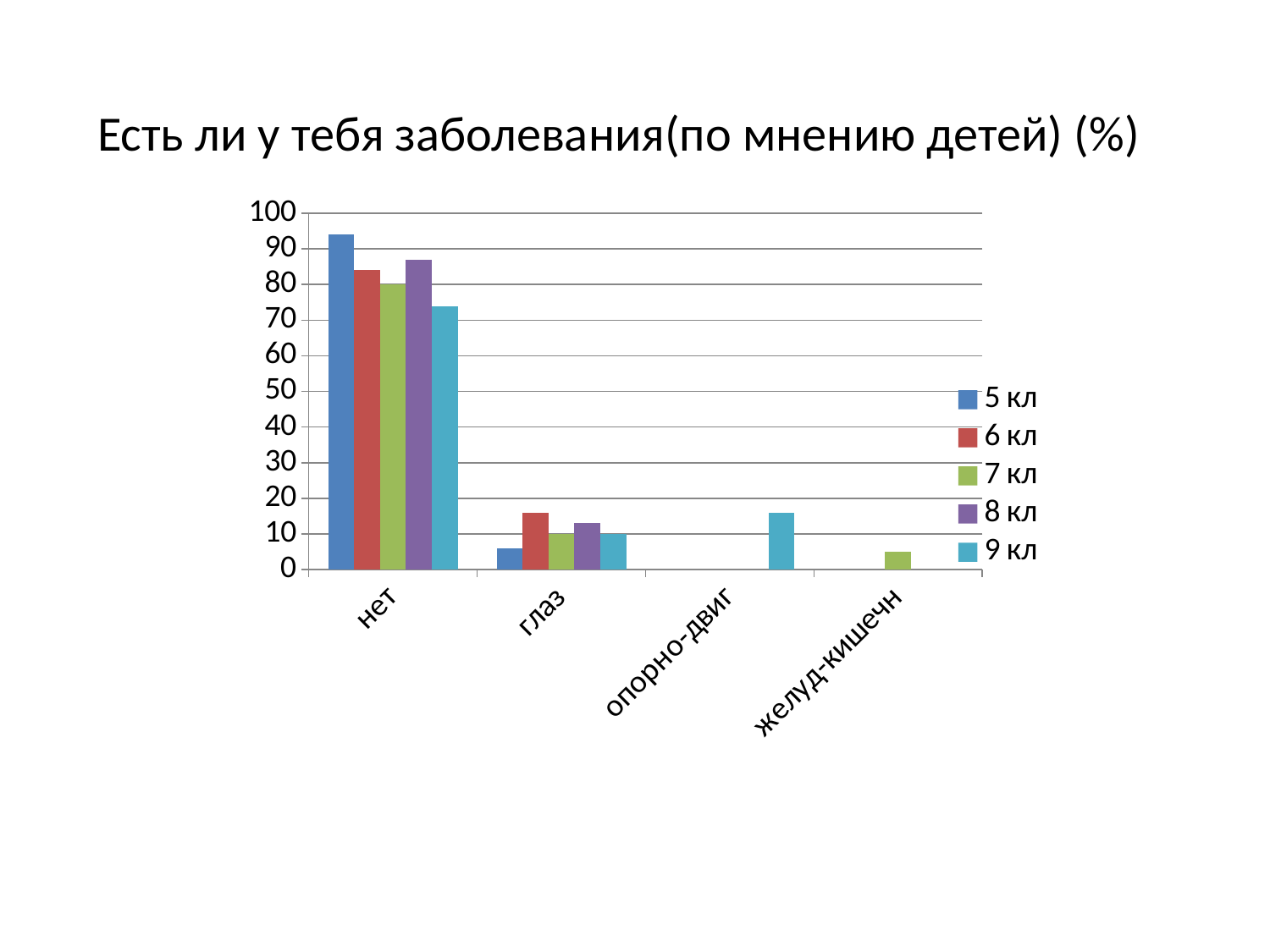
Is the value for "5 кл" in the category "нет" greater or less than 90? greater Is the value for "6 кл" in the category "глаз" greater or less than 10? greater Which series is the only one with a visible bar in the category "опорно-двиг"? 9 кл How many categories are shown on the x axis? 4 Which series has the lowest value for the category "нет"? 9 кл Which series has the highest value for the category "глаз"? 6 кл Which is larger for the category "нет": the value for "8 кл" or the value for "6 кл"? 8 кл What is the title of the chart? Есть ли у тебя заболевания(по мнению детей) (%) What kind of chart is shown on the slide? bar chart How many series does the legend list? 5 Which series has the highest value for the category "нет"? 5 кл Is the value for "9 кл" in the category "нет" greater or less than 80? less